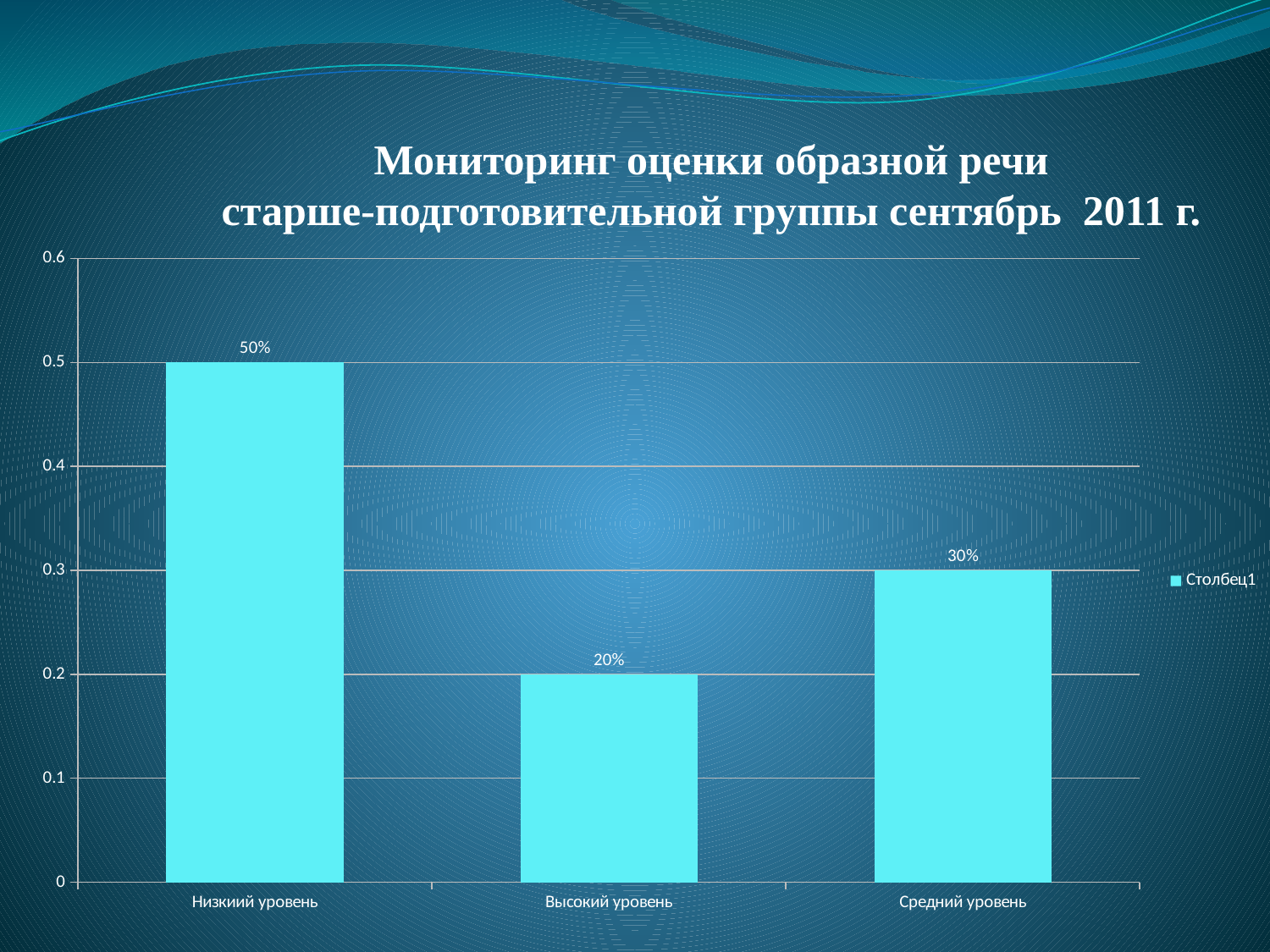
Which category has the highest value? Низкиий уровень What is the value for Средний уровень? 30% Is the value for Низкиий уровень greater or less than 0.4? greater What series name does the legend list? Столбец1 What kind of chart is shown on the slide? bar chart What is the value for Низкиий уровень? 50% How many categories are shown on the x axis? 3 What is the difference between the values for Средний уровень and Высокий уровень? 10% Which category has the lowest value? Высокий уровень What is the value for Высокий уровень? 20% What is the difference between the values for Низкиий уровень and Средний уровень? 20% Which is larger, the value for Высокий уровень or the value for Средний уровень? Средний уровень